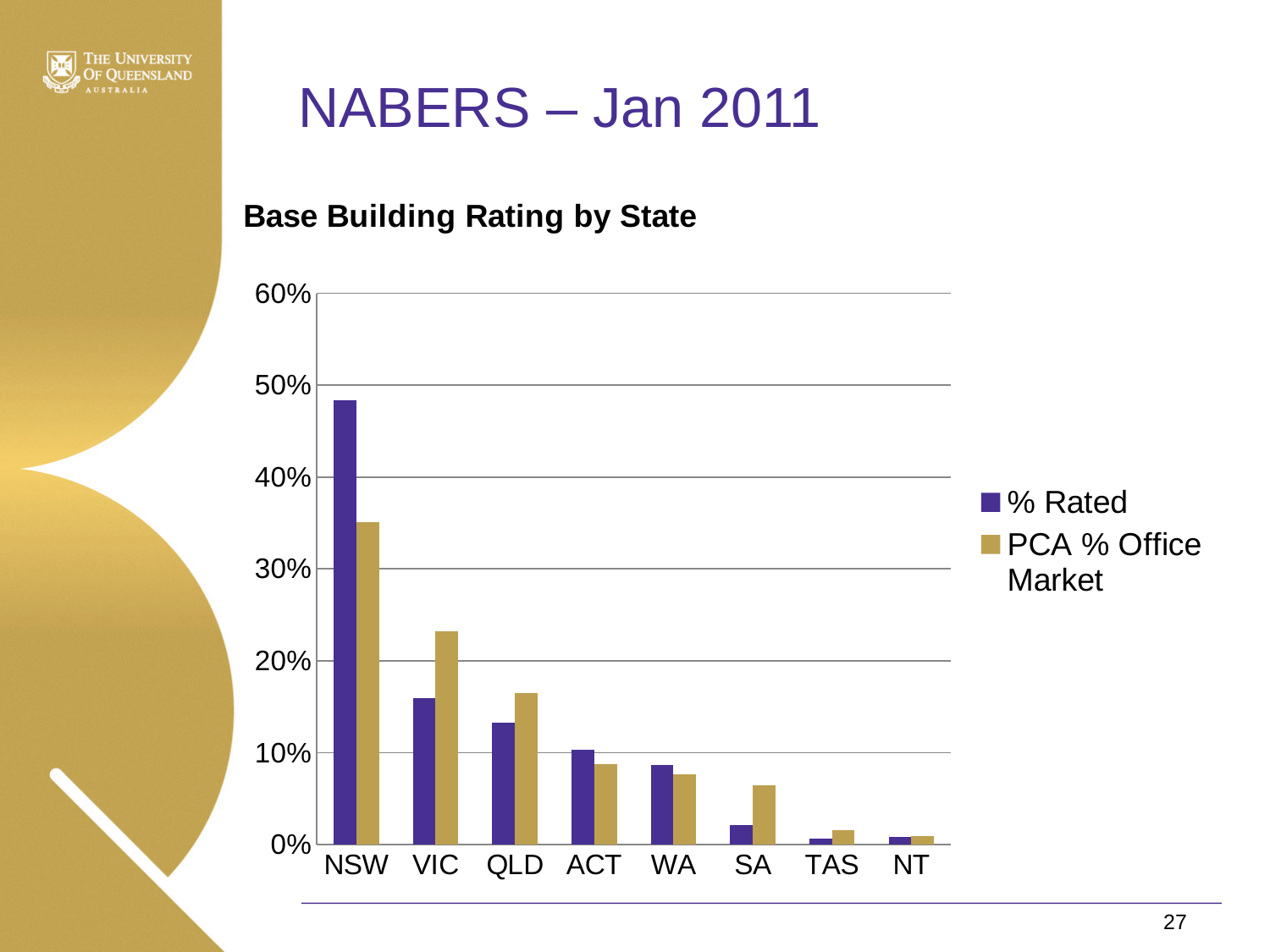
Is the % Rated value for NSW greater or less than 40%? greater How many states are shown on the x axis of the chart? 8 Is the % Rated value for QLD greater or less than 10%? greater What kind of chart is shown on the slide? bar chart Which state has the highest PCA % Office Market value? NSW For VIC, which is larger: % Rated or PCA % Office Market? PCA % Office Market How many series does the chart's legend list? 2 For SA, which is larger: % Rated or PCA % Office Market? PCA % Office Market Is the PCA % Office Market value for NSW greater or less than 30%? greater What is the title of the chart? Base Building Rating by State Which state has the highest % Rated value? NSW